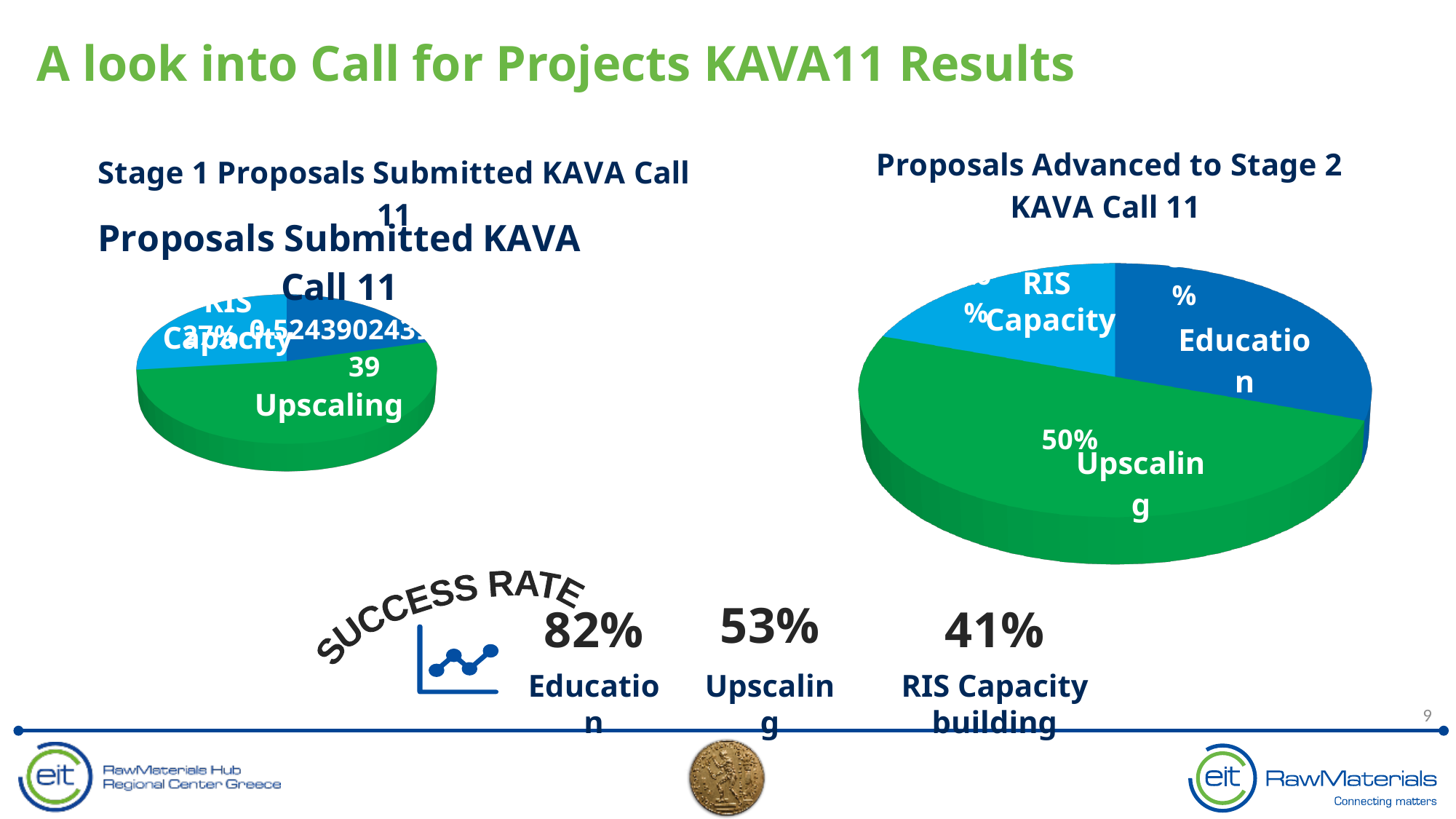
In the 'Proposals Advanced to Stage 2 KAVA Call 11' chart, which category has the smallest slice? RIS Capacity What is the title of the pie chart on the right side of the slide? Proposals Advanced to Stage 2 KAVA Call 11 What kind of chart is the 'Proposals Submitted KAVA Call 11' chart on the left? Pie chart In the 'Proposals Advanced to Stage 2 KAVA Call 11' chart, what share does Upscaling have? 50% In the 'Proposals Advanced to Stage 2 KAVA Call 11' chart, which slice is larger: Education or RIS Capacity? Education What kind of chart is the 'Proposals Advanced to Stage 2 KAVA Call 11' chart? Pie chart How many slices does the 'Proposals Advanced to Stage 2 KAVA Call 11' pie chart have? 3 In the 'Proposals Advanced to Stage 2 KAVA Call 11' chart, which category has the largest slice? Upscaling In the 'Proposals Advanced to Stage 2 KAVA Call 11' chart, what colour is the Upscaling slice? Green In the 'Proposals Submitted KAVA Call 11' chart on the left, which category has the largest slice? Upscaling